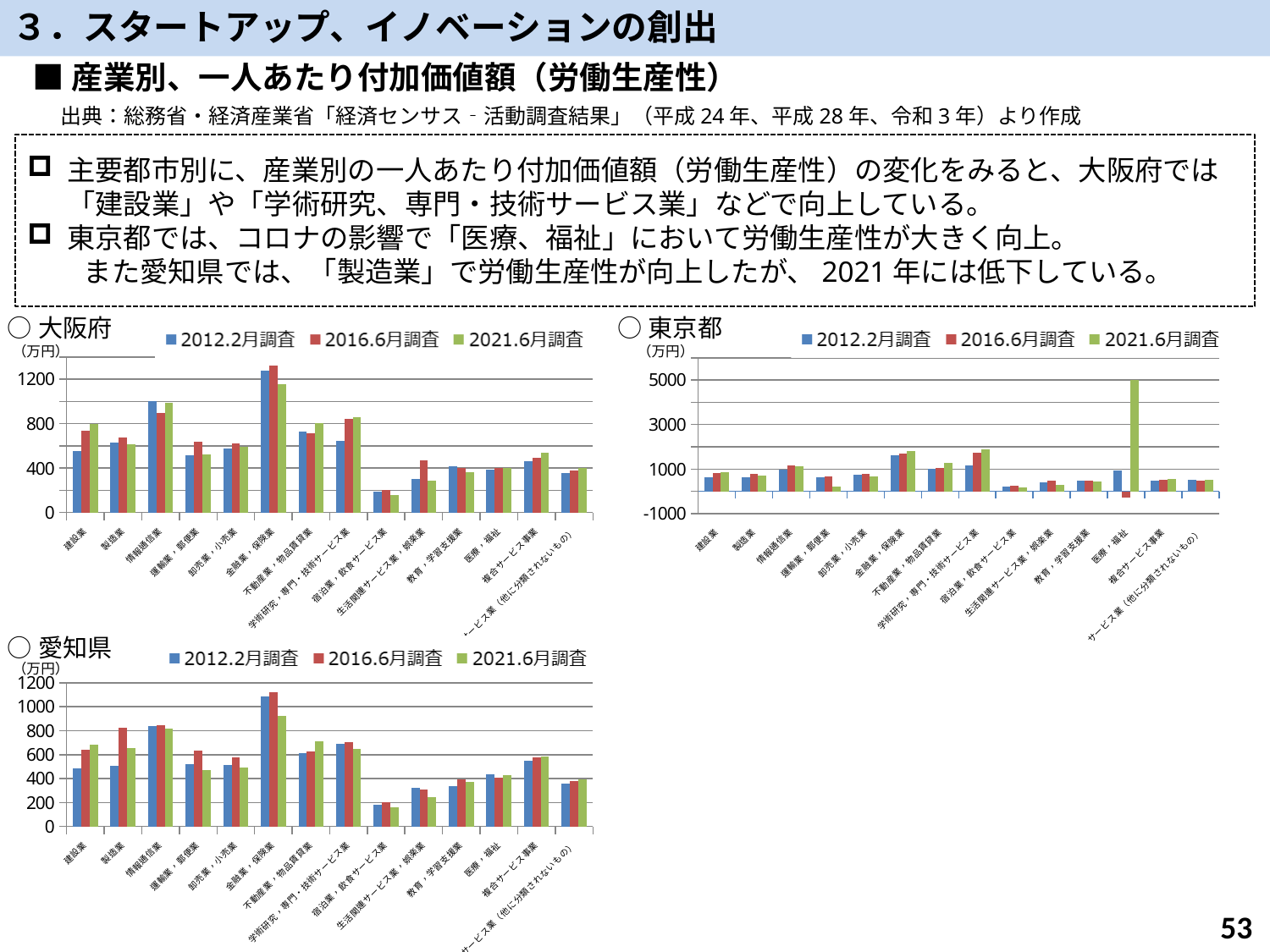
In the 愛知県 chart, which industry has the highest value in the 2012.2月調査 series? 金融業，保険業 In the 大阪府 chart, is the 2021.6月調査 value for 建設業 greater or less than 400? greater In the 愛知県 chart, is the 2016.6月調査 value for 製造業 greater or less than 800? greater How many series does the legend of the 東京都 chart list? 3 In the 愛知県 chart, which is larger for 製造業: the 2016.6月調査 value or the 2021.6月調査 value? 2016.6月調査 What kind of chart is the 大阪府 chart? bar chart What unit is shown on the y axis of the 大阪府 chart? 万円 In the 大阪府 chart, which industry has the highest value in the 2016.6月調査 series? 金融業，保険業 In the 東京都 chart, is the 2021.6月調査 value for 医療，福祉 greater or less than 3000? greater In the 東京都 chart, which industry has the highest value in the 2021.6月調査 series? 医療，福祉 How many industry categories are shown on the x axis of the 愛知県 chart? 14 In the 大阪府 chart, which industry has the lowest value in the 2021.6月調査 series? 宿泊業，飲食サービス業